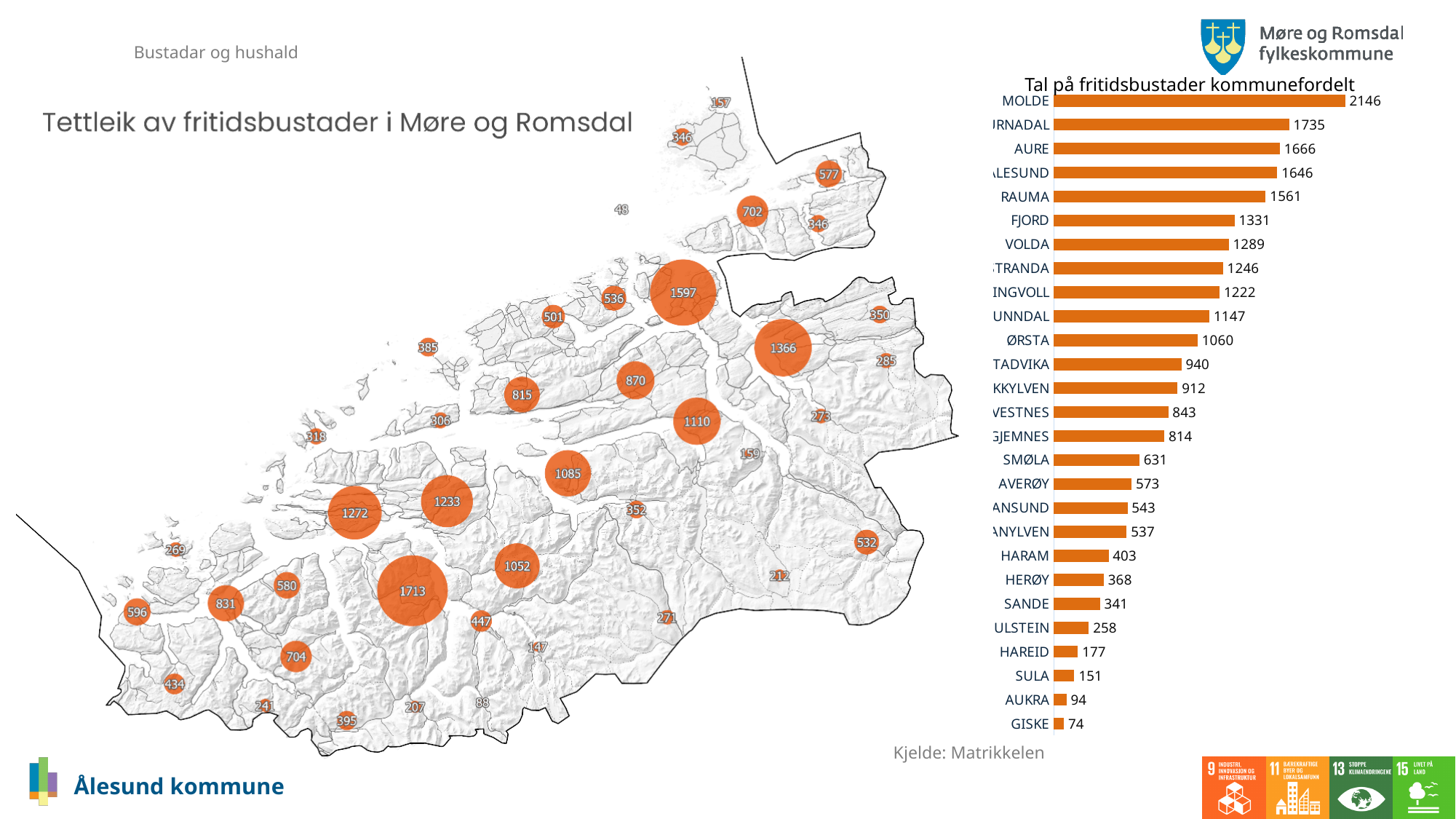
In the bar chart 'Tal på fritidsbustader kommunefordelt', which municipality has the highest value? MOLDE How many municipalities are shown in the bar chart 'Tal på fritidsbustader kommunefordelt'? 27 In the bar chart 'Tal på fritidsbustader kommunefordelt', what is the value for SMØLA? 631 What kind of chart is 'Tal på fritidsbustader kommunefordelt'? Bar chart In the bar chart 'Tal på fritidsbustader kommunefordelt', which has a larger value, FJORD or ØRSTA? FJORD In the bar chart 'Tal på fritidsbustader kommunefordelt', what is the value for MOLDE? 2146 In the bar chart 'Tal på fritidsbustader kommunefordelt', which municipality has the lowest value? GISKE In the bar chart 'Tal på fritidsbustader kommunefordelt', which has a larger value, HARAM or HERØY? HARAM In the bar chart 'Tal på fritidsbustader kommunefordelt', what is the value for RAUMA? 1561 In the bar chart 'Tal på fritidsbustader kommunefordelt', what is the difference between the values for AURE and VOLDA? 377 In the bar chart 'Tal på fritidsbustader kommunefordelt', what is the value for AUKRA? 94 What is the source cited below the bar chart on the slide? Kjelde: Matrikkelen